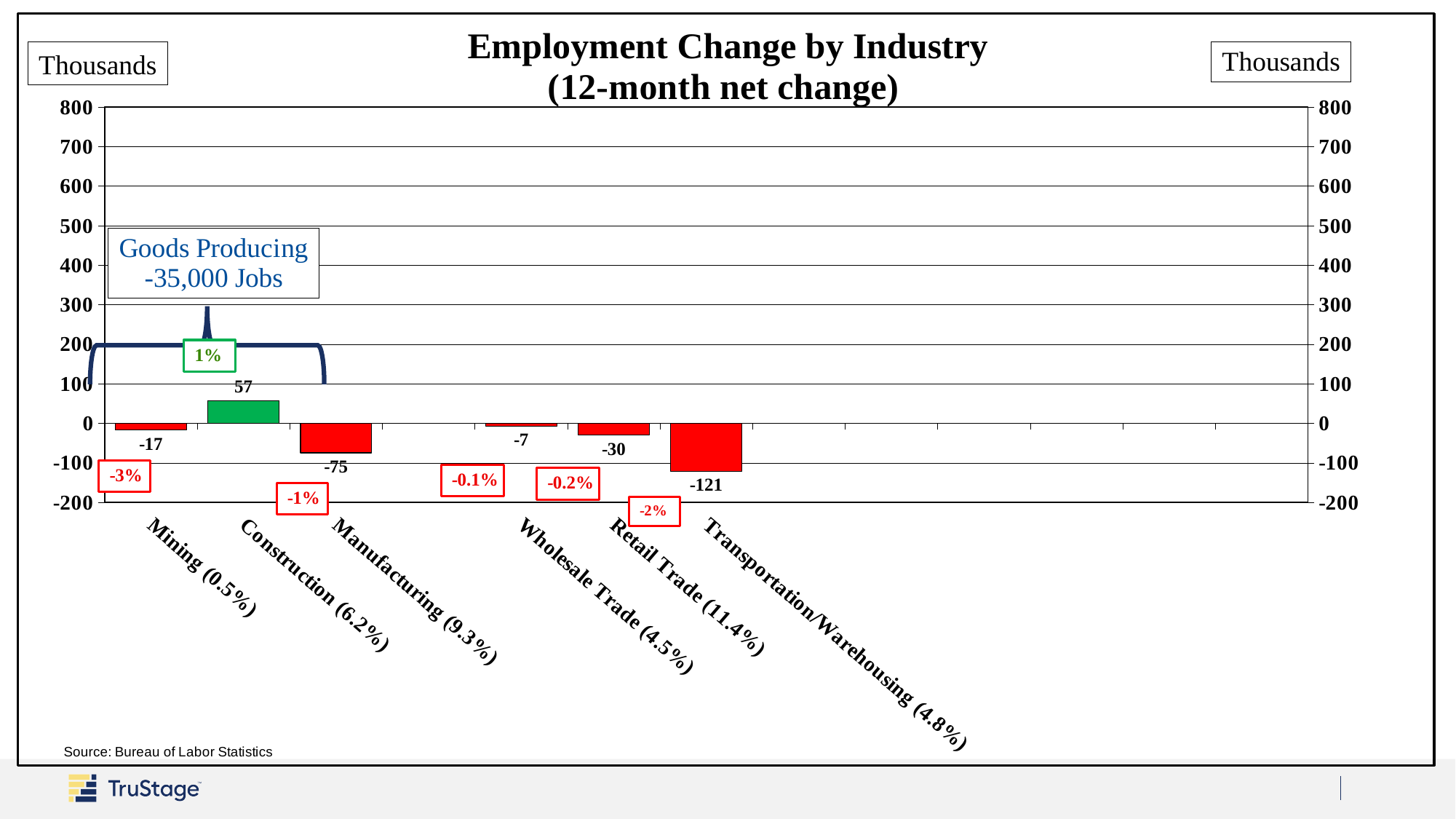
Which industry has the highest employment change? Construction (6.2%) What is the title of the chart? Employment Change by Industry (12-month net change) What is the value for Construction (6.2%)? 57 What is the value for Manufacturing (9.3%)? -75 How many industries are labeled on the x axis? 6 Which industry has the lowest employment change? Transportation/Warehousing (4.8%) Which is larger, the value for Mining (0.5%) or the value for Wholesale Trade (4.5%)? Wholesale Trade (4.5%) What kind of chart is shown on the slide? bar chart What is the value for Retail Trade (11.4%)? -30 What is the value for Transportation/Warehousing (4.8%)? -121 What is the difference between the values for Construction (6.2%) and Manufacturing (9.3%)? 132 Is the value for Transportation/Warehousing (4.8%) greater or less than -100? less